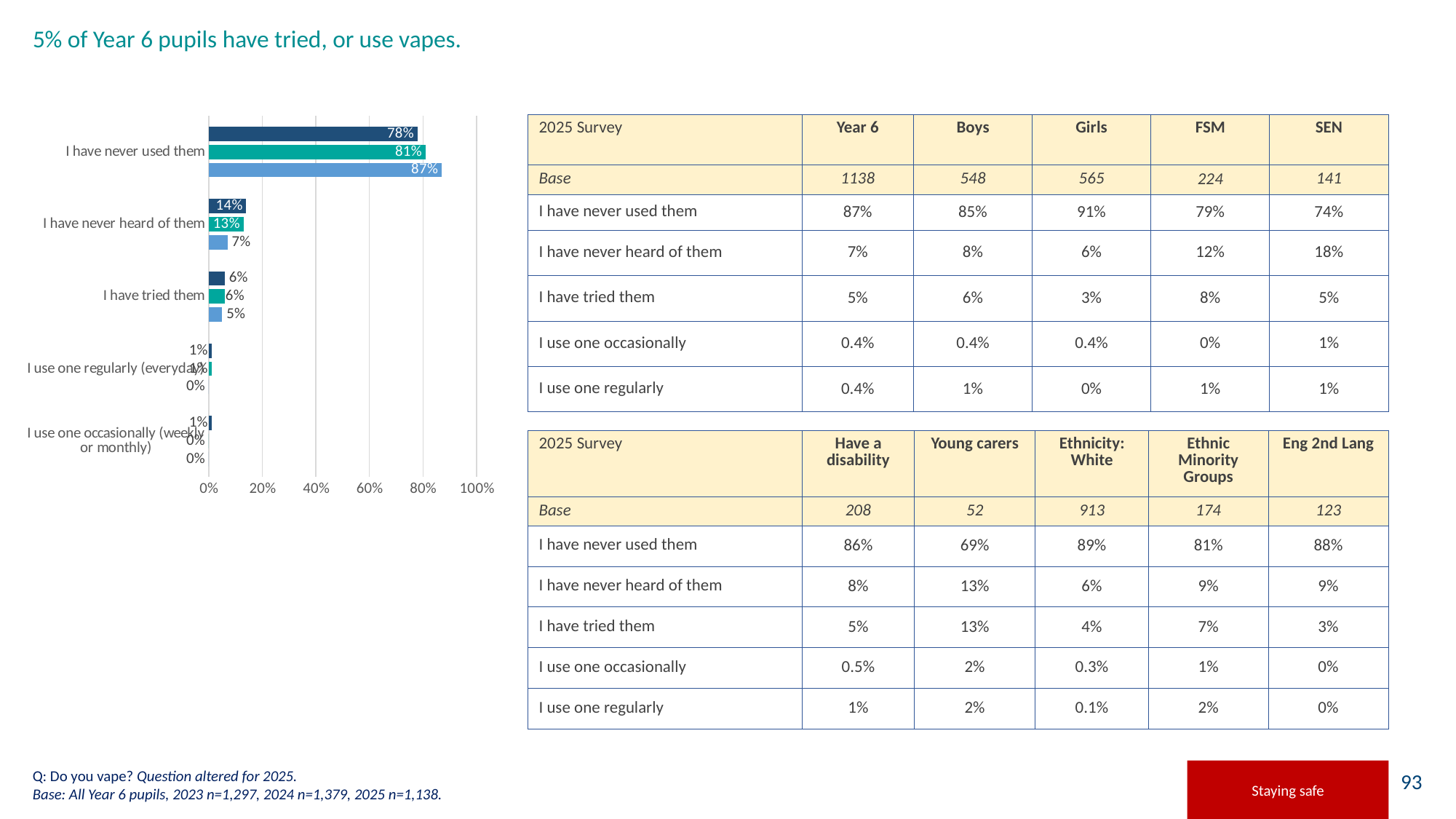
How many categories are shown on the bar chart? 5 On the bar chart, what is the value of the teal bar for 'I have never heard of them'? 13% On the bar chart, what is the value of the light blue bar for 'I have tried them'? 5% On the bar chart, what is the value of the dark blue bar for 'I have never used them'? 78% Which category has the longest bars on the bar chart? I have never used them On the bar chart, for 'I have never heard of them', is the dark blue bar or the light blue bar larger? dark blue How many bars are plotted for each category on the bar chart? 3 On the bar chart, is the light blue bar for 'I have never used them' greater or less than 80%? greater On the bar chart, what is the difference between the light blue bar (87%) and the dark blue bar (78%) for 'I have never used them'? 9% On the bar chart, what is the difference between the dark blue bar (14%) and the light blue bar (7%) for 'I have never heard of them'? 7% What kind of chart is shown on the left of the slide? bar chart On the bar chart, what is the value of the light blue bar for 'I have never used them'? 87%